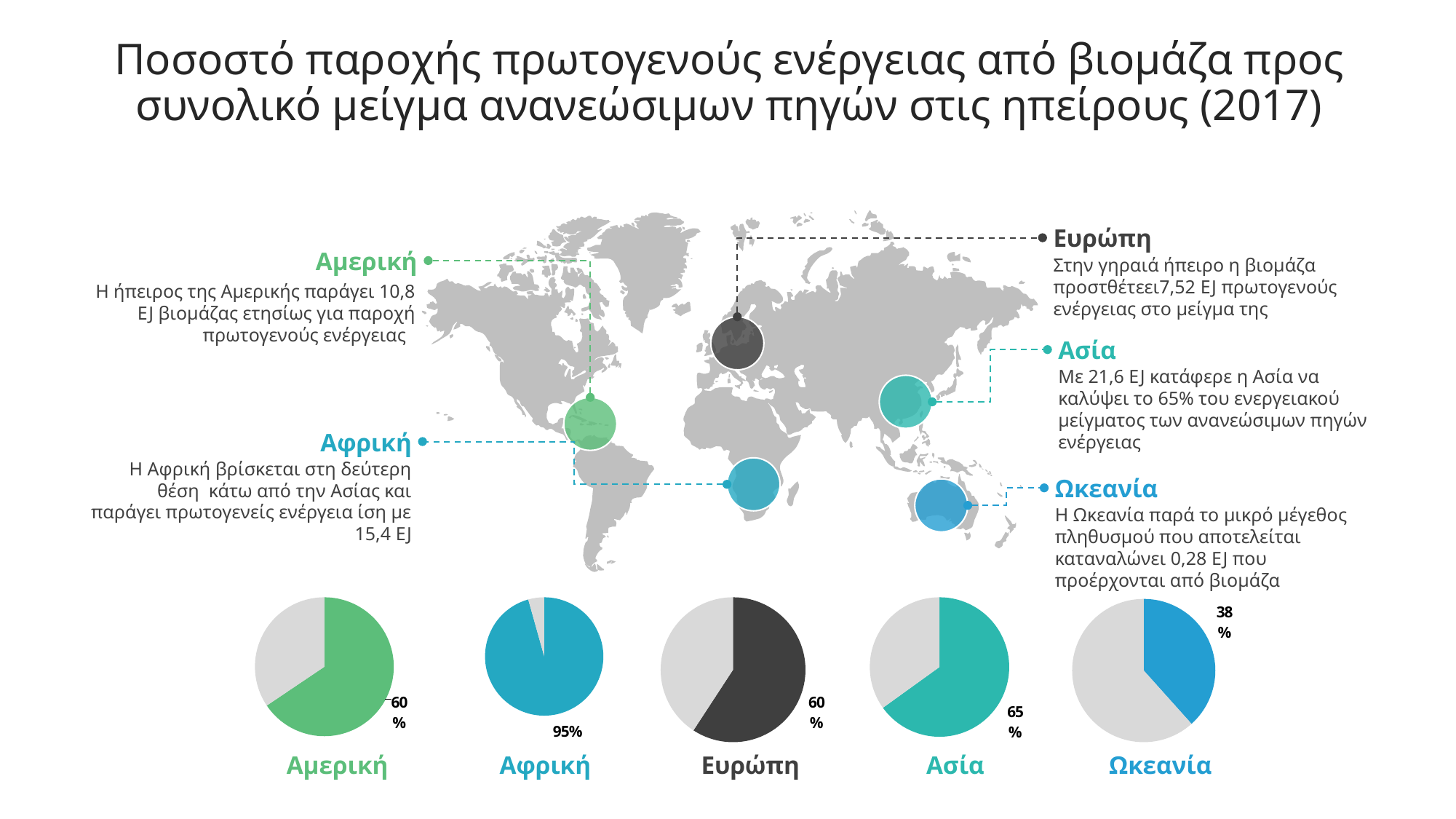
In the pie chart labelled Ωκεανία, what percentage does the blue slice show? 38% In the pie chart labelled Ασία, what percentage does the teal slice show? 65% In the pie chart labelled Αφρική, what percentage does the blue slice show? 95% How many pie charts are shown at the bottom of the slide? 5 What is the difference between the labelled percentage in the Αφρική pie chart and the labelled percentage in the Ωκεανία pie chart? 57% Across the five pie charts at the bottom of the slide, which continent has the highest labelled percentage? Αφρική In the pie chart labelled Αμερική, what percentage does the green slice show? 60% In the pie chart labelled Ευρώπη, what percentage does the dark slice show? 60% Across the five pie charts at the bottom of the slide, which continent has the lowest labelled percentage? Ωκεανία What type of chart is used for each continent at the bottom of the slide? Pie chart What colour is the labelled slice in the Ευρώπη pie chart? Dark grey Which is larger: the labelled percentage in the Ασία pie chart or the labelled percentage in the Αμερική pie chart? Ασία